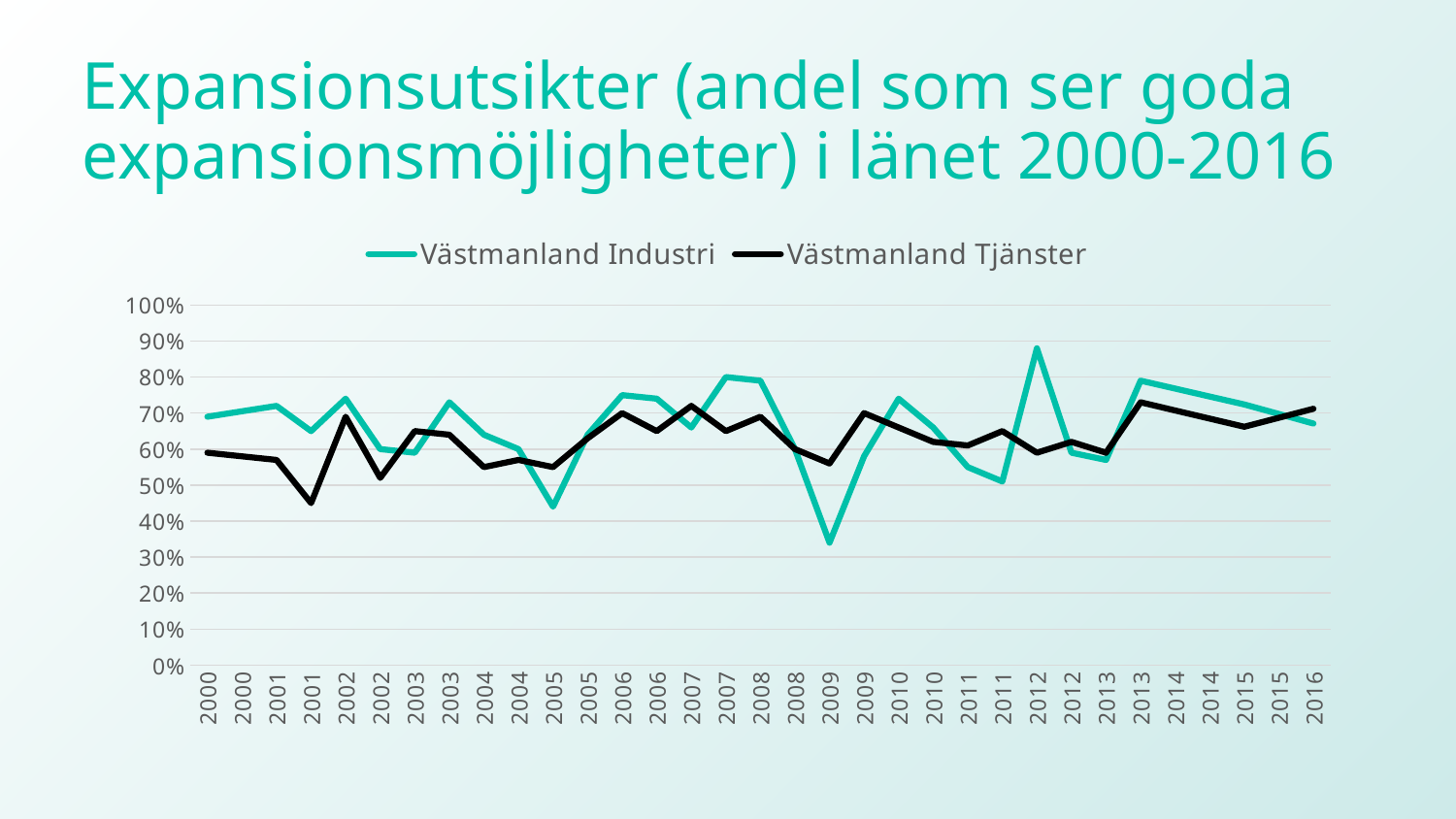
What are the two series named in the legend? Västmanland Industri and Västmanland Tjänster At the second point labelled 2009, which series has the higher value, Västmanland Industri or Västmanland Tjänster? Västmanland Tjänster Is the value for Västmanland Industri at the first point labelled 2005 greater or less than 50%? less How many distinct years are labelled on the x axis? 17 At which x-axis point does Västmanland Industri reach its highest value? 2012 (first point) How many series does the legend list? 2 What kind of chart is shown on the slide? line chart Is the value for Västmanland Industri at the second point labelled 2009 greater or less than 40%? greater At which x-axis point does Västmanland Industri reach its lowest value? 2009 (first point) Which series is drawn in black? Västmanland Tjänster Is the value for Västmanland Tjänster at the second point labelled 2001 greater or less than 50%? less